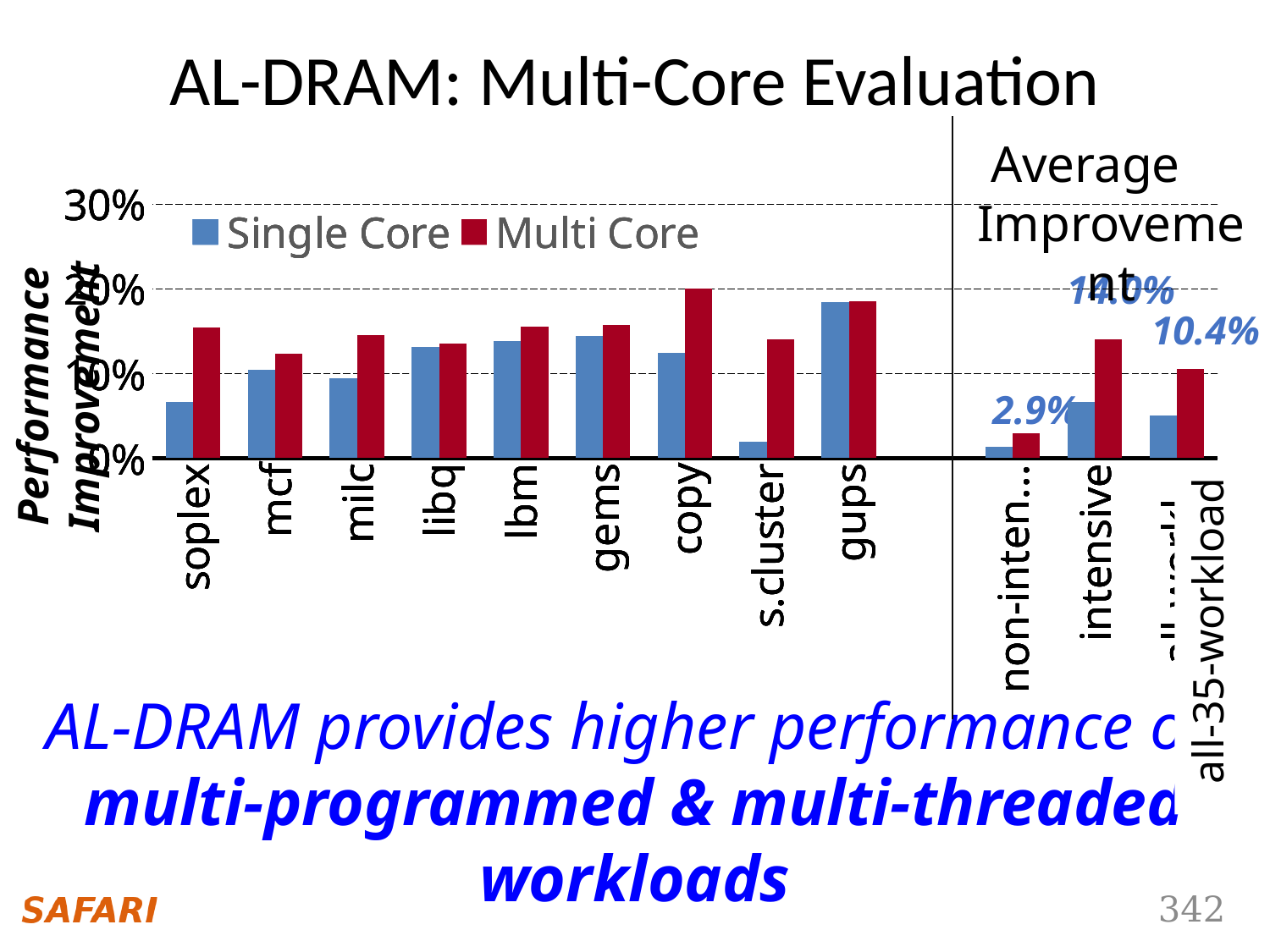
Among the nine individual benchmarks (soplex through gups), which has the lowest Single Core performance improvement? s.cluster What is the labelled Multi Core value for the all-35-workload group? 10.4% What type of chart is shown on the slide? bar chart What are the two series named in the legend? Single Core and Multi Core For soplex, which is larger: the Single Core or the Multi Core performance improvement? Multi Core Among the nine individual benchmarks (soplex through gups), which has the highest Single Core performance improvement? gups Is the Single Core value for gups greater or less than 10%? greater How many series does the legend list? 2 How many categories are shown along the x axis? 12 Is the Single Core value for s.cluster greater or less than 10%? less What is the labelled Multi Core value for the non-intensive workload group? 2.9% What colour are the Multi Core bars? red